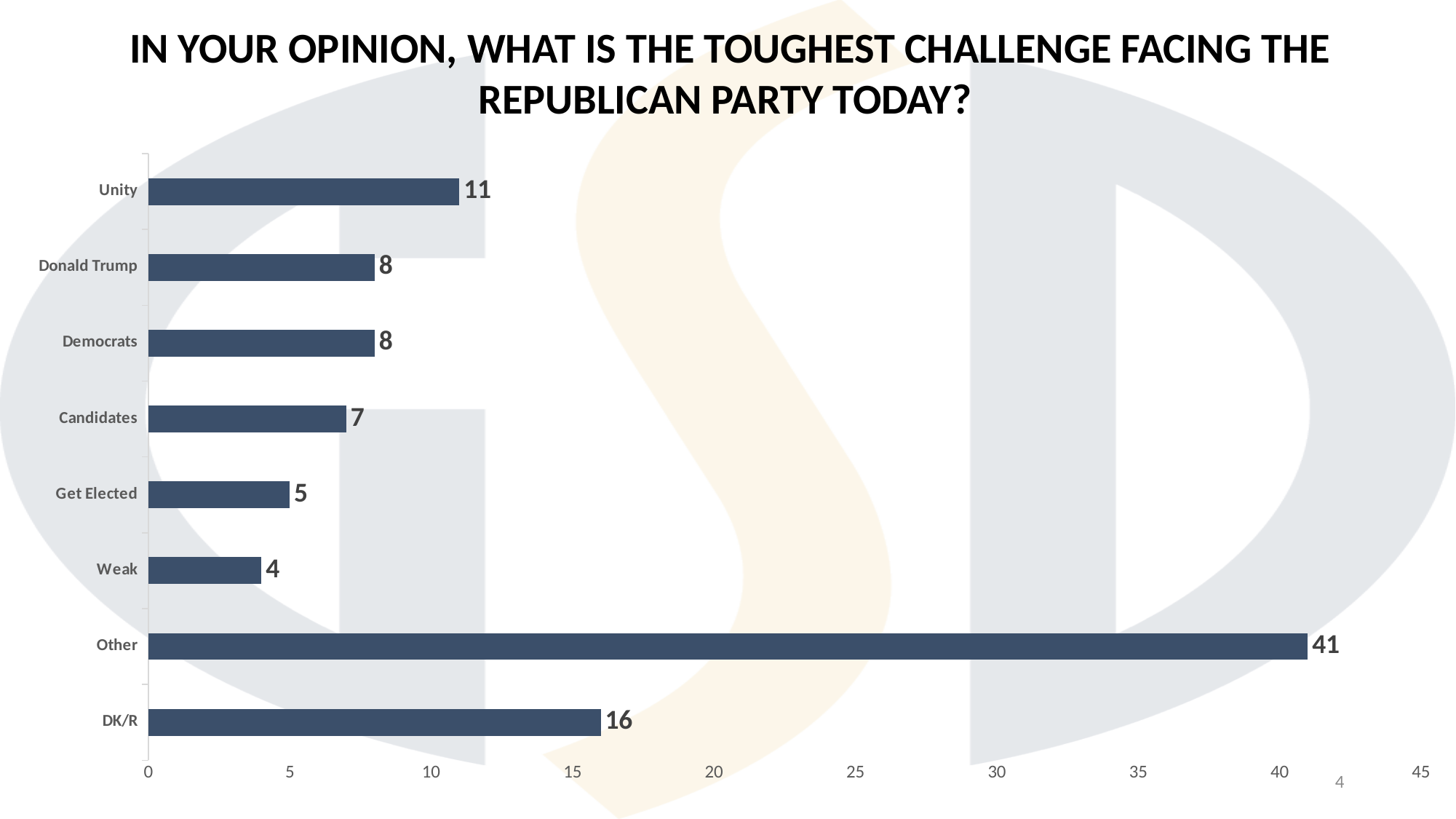
How many categories are shown in the chart? 8 What is the value for DK/R? 16 Which is larger, the value for Unity or the value for Donald Trump? Unity Which category has the lowest value? Weak What is the difference between the values for Other and DK/R? 25 What is the difference between the values for Unity and Candidates? 4 What is the value for Other? 41 What is the title of the chart? In your opinion, what is the toughest challenge facing the Republican Party today? What is the value for Unity? 11 What is the value for Get Elected? 5 What kind of chart is shown on the slide? Bar chart Which category has the highest value? Other